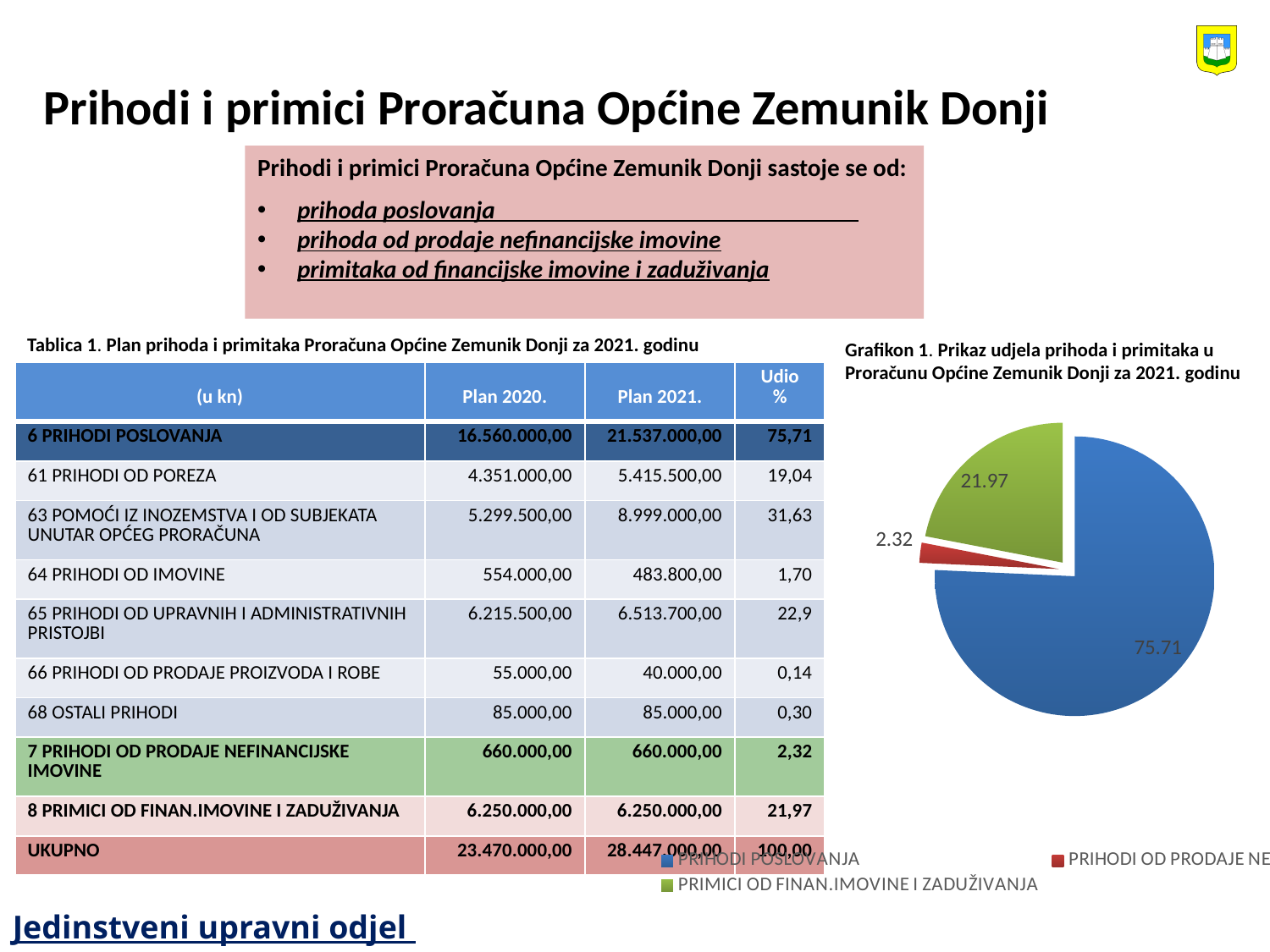
What is the value of the smallest slice in the pie chart? 2.32 Which slice of the pie chart is the largest? PRIHODI POSLOVANJA How many entries does the legend of the pie chart list? 3 In the pie chart, what is the difference between the PRIHODI POSLOVANJA slice and the PRIMICI OD FINAN.IMOVINE I ZADUŽIVANJA slice? 53.74 In the pie chart, what value is shown for PRIHODI POSLOVANJA? 75.71 In the pie chart, what value is shown for PRIMICI OD FINAN.IMOVINE I ZADUŽIVANJA? 21.97 In the pie chart, what is the difference between the PRIMICI OD FINAN.IMOVINE I ZADUŽIVANJA slice and the red slice? 19.65 What colour is the PRIHODI POSLOVANJA slice in the pie chart? Blue What kind of chart is Grafikon 1 on the slide? Pie chart In the pie chart, what value is shown on the red slice? 2.32 In the pie chart, which is larger: PRIHODI POSLOVANJA or PRIMICI OD FINAN.IMOVINE I ZADUŽIVANJA? PRIHODI POSLOVANJA How many slices does the pie chart (Grafikon 1) have? 3